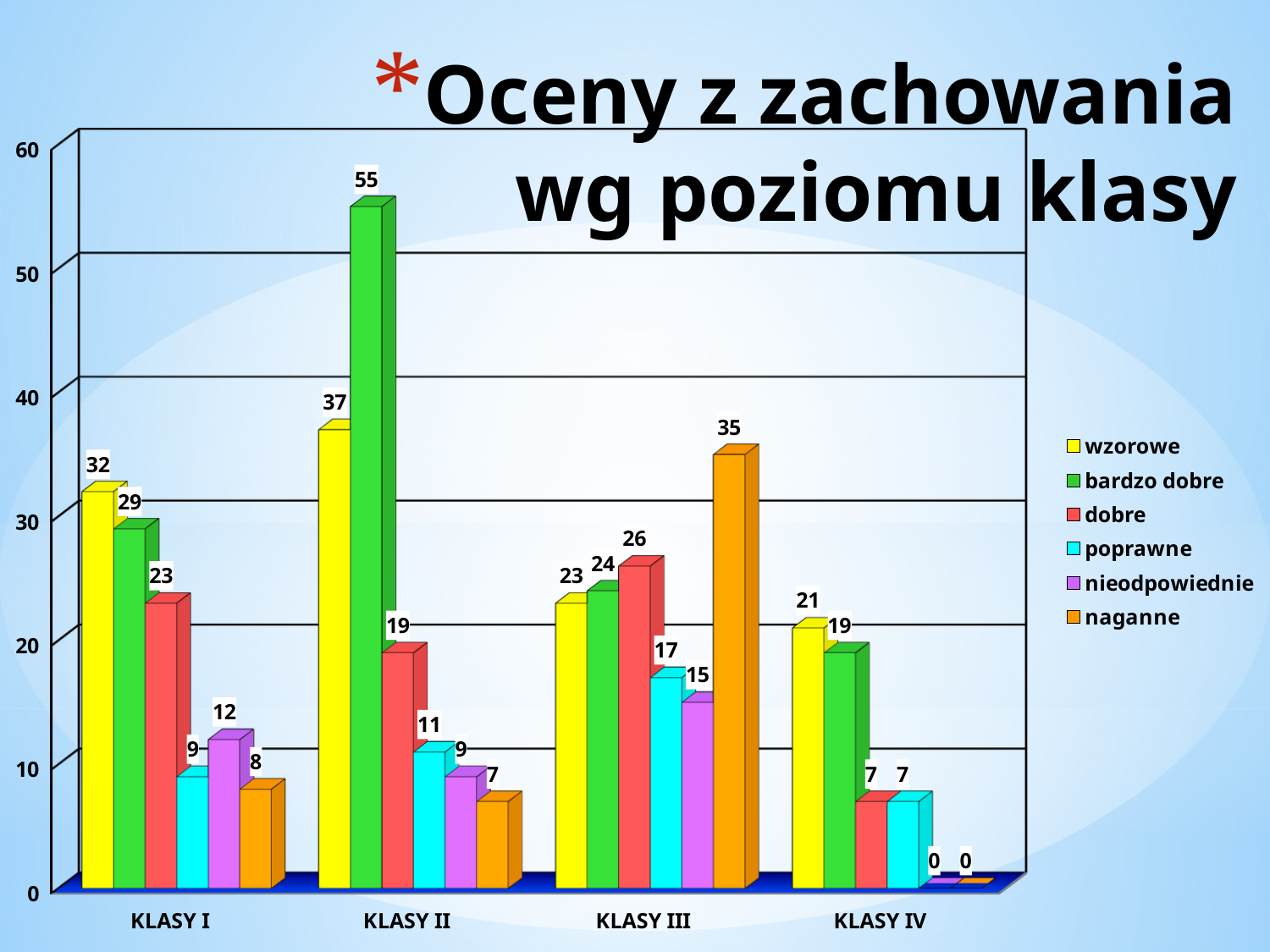
Which category has the highest value for "wzorowe"? KLASY II What is the value for "bardzo dobre" in KLASY II? 55 What kind of chart is shown on the slide? bar chart What is the value for "naganne" in KLASY III? 35 Which category has the lowest value for "dobre"? KLASY IV What is the title of the chart? Oceny z zachowania wg poziomu klasy What is the value for "nieodpowiednie" in KLASY I? 12 How many series does the legend list? 6 What is the value for "poprawne" in KLASY IV? 7 How many categories are shown on the x axis? 4 What is the difference between the "wzorowe" and "bardzo dobre" values in KLASY II? 18 Which is larger in KLASY III: the value for "dobre" or the value for "naganne"? naganne